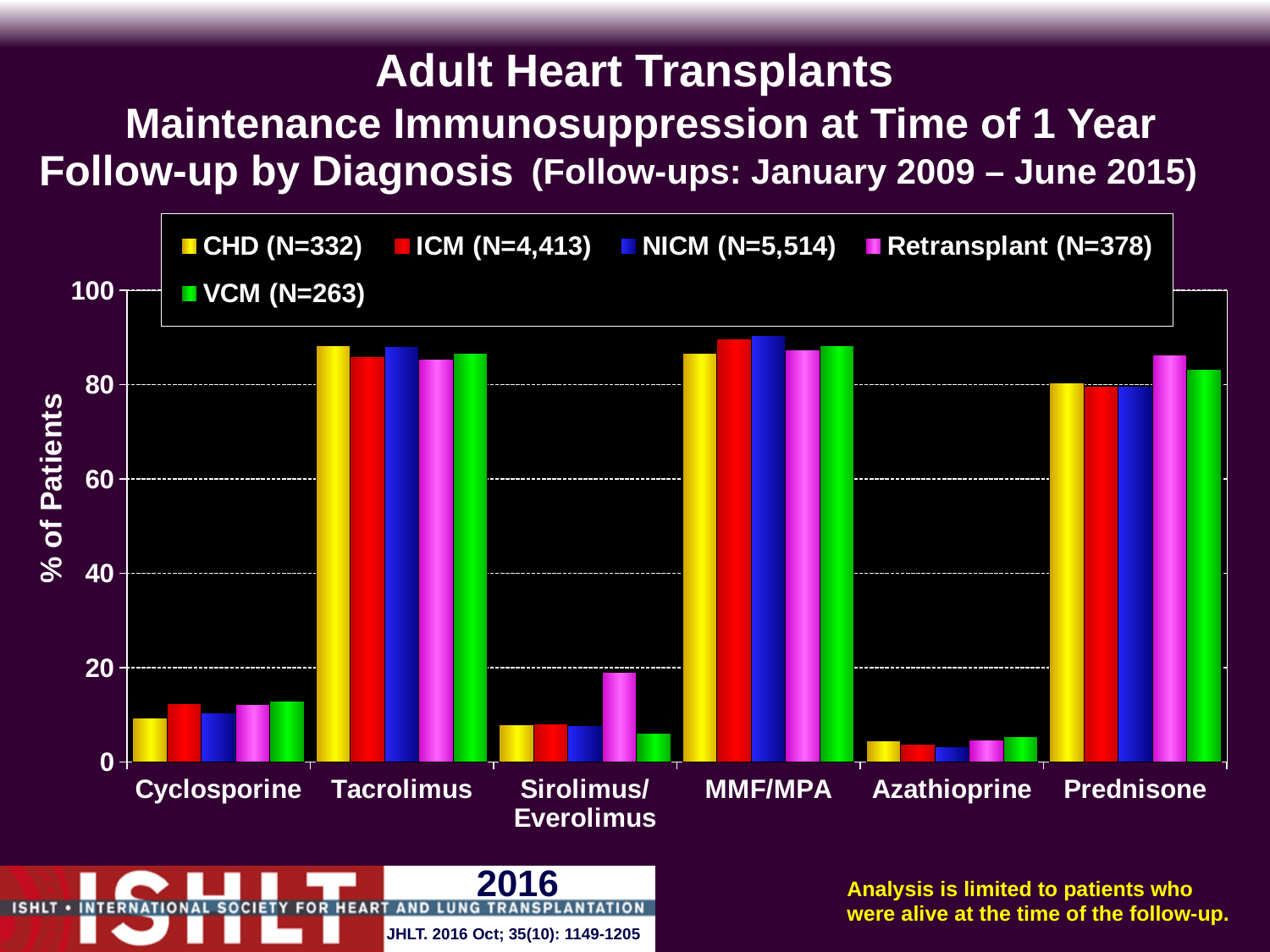
Is the value for Retransplant in the Prednisone category greater or less than 80? greater Is the value for CHD in the Tacrolimus category greater or less than 80? greater Which drug category has the lowest values across all series? Azathioprine In the Sirolimus/Everolimus category, which series has the highest value? Retransplant (N=378) How many drug categories are shown on the x axis? 6 What is the label on the y axis? % of Patients In the Sirolimus/Everolimus category, which is larger: the Retransplant value or the VCM value? Retransplant Is the value for VCM in the Cyclosporine category greater or less than 20? less What kind of chart is shown on the slide? bar chart How many series does the legend list? 5